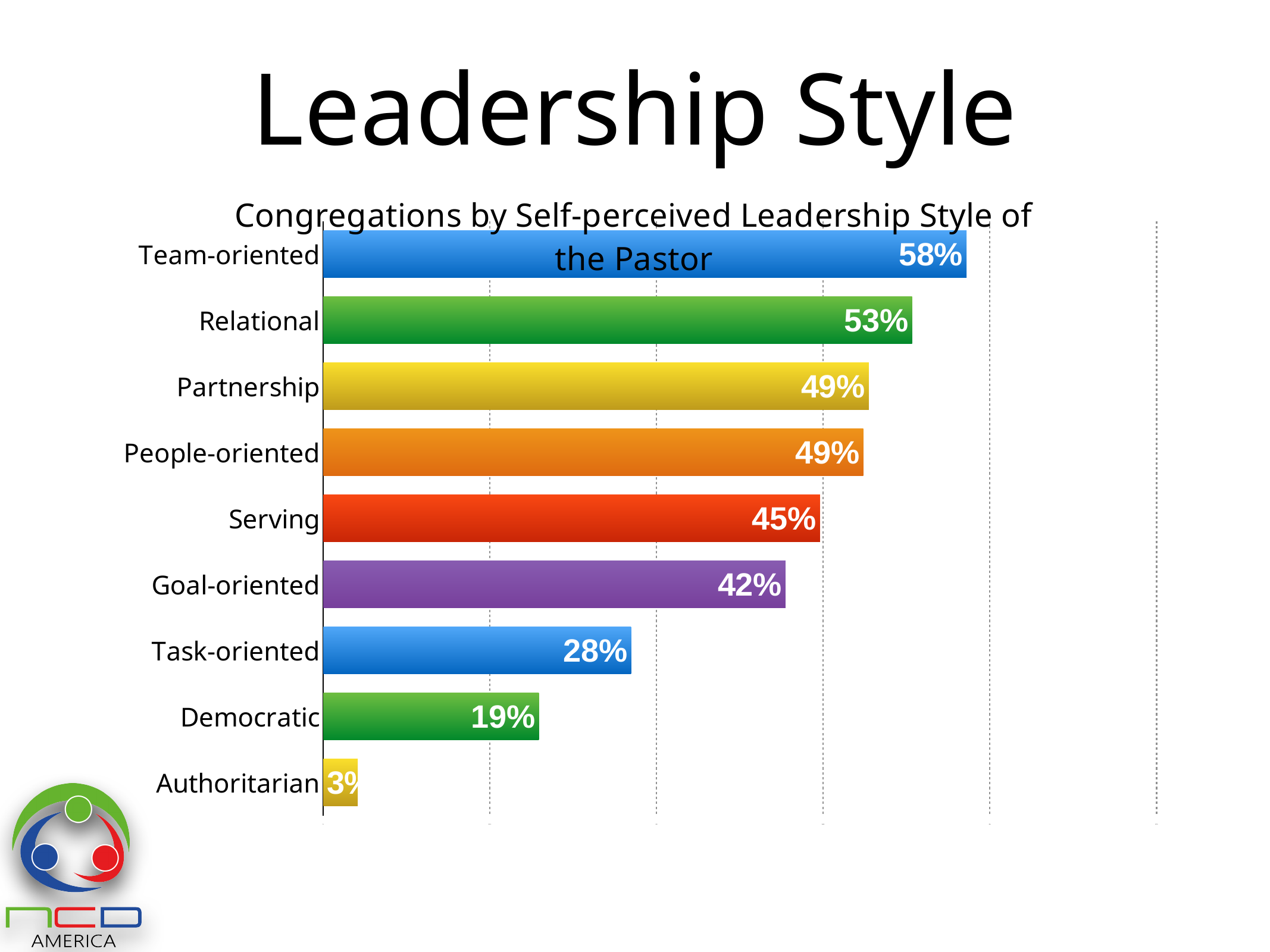
Which is larger, the value for Serving or the value for Goal-oriented? Serving What is the value for Team-oriented? 58% What kind of chart is shown on the slide? Bar chart How many leadership style categories are shown in the chart? 9 What is the difference between the values for Goal-oriented and Task-oriented? 14% What is the value for Task-oriented? 28% What is the value for Relational? 53% Which leadership style has the lowest value? Authoritarian What is the value for Serving? 45% What is the value for Democratic? 19% Which leadership style has the highest value? Team-oriented What is the difference between the values for Team-oriented and Relational? 5%